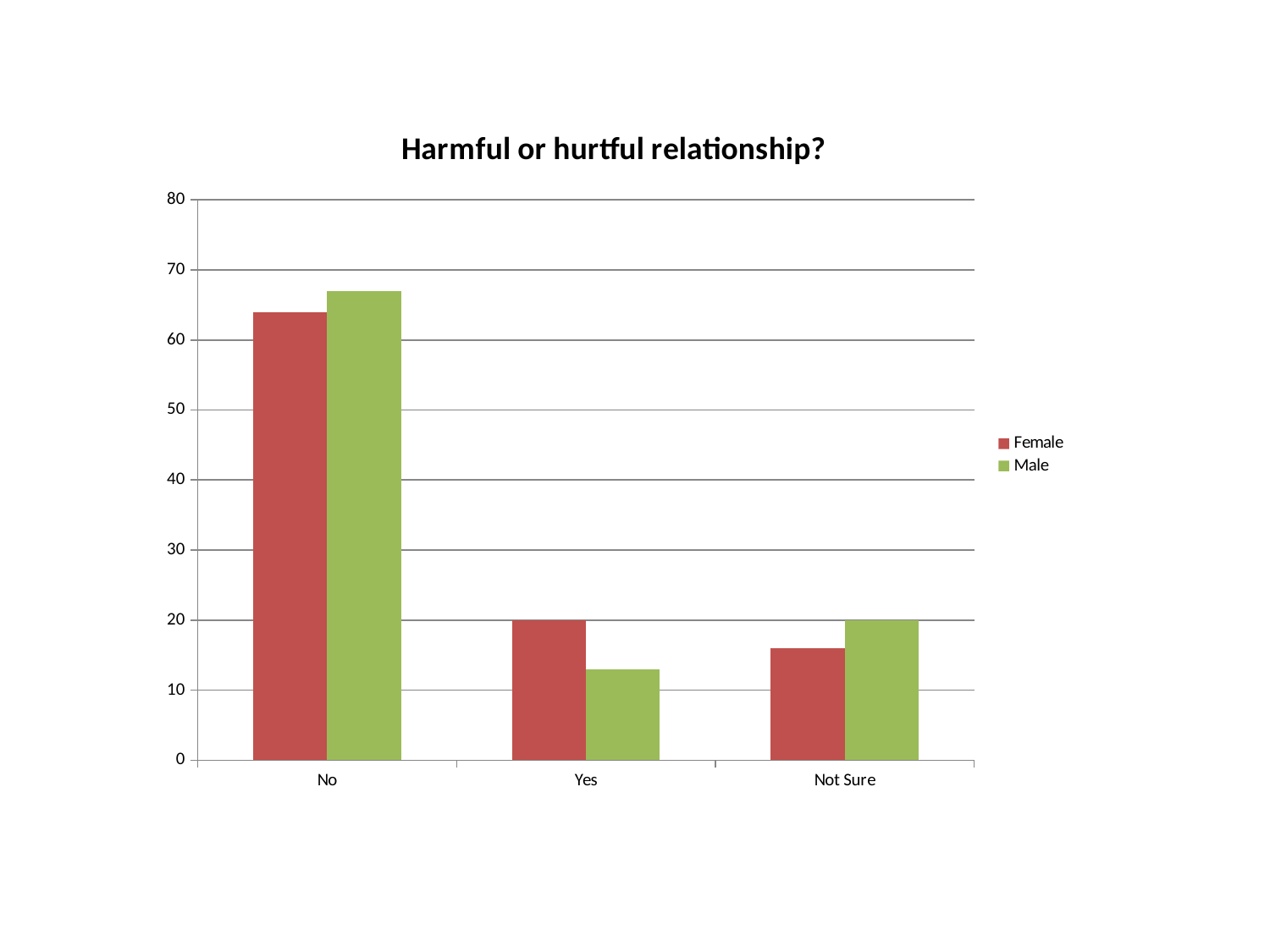
Which category has the highest Female value? No What is the Female value for Yes? 20 What is the Male value for Not Sure? 20 How many series does the legend list? 2 What is the title of the chart? Harmful or hurtful relationship? How many categories are shown on the x axis? 3 What kind of chart is shown on the slide? bar chart For Not Sure, which is larger, the Female value or the Male value? Male Which category has the lowest Male value? Yes Is the Male value for No greater or less than 60? greater For Yes, which is larger, the Female value or the Male value? Female Is the Male value for Yes greater or less than 20? less